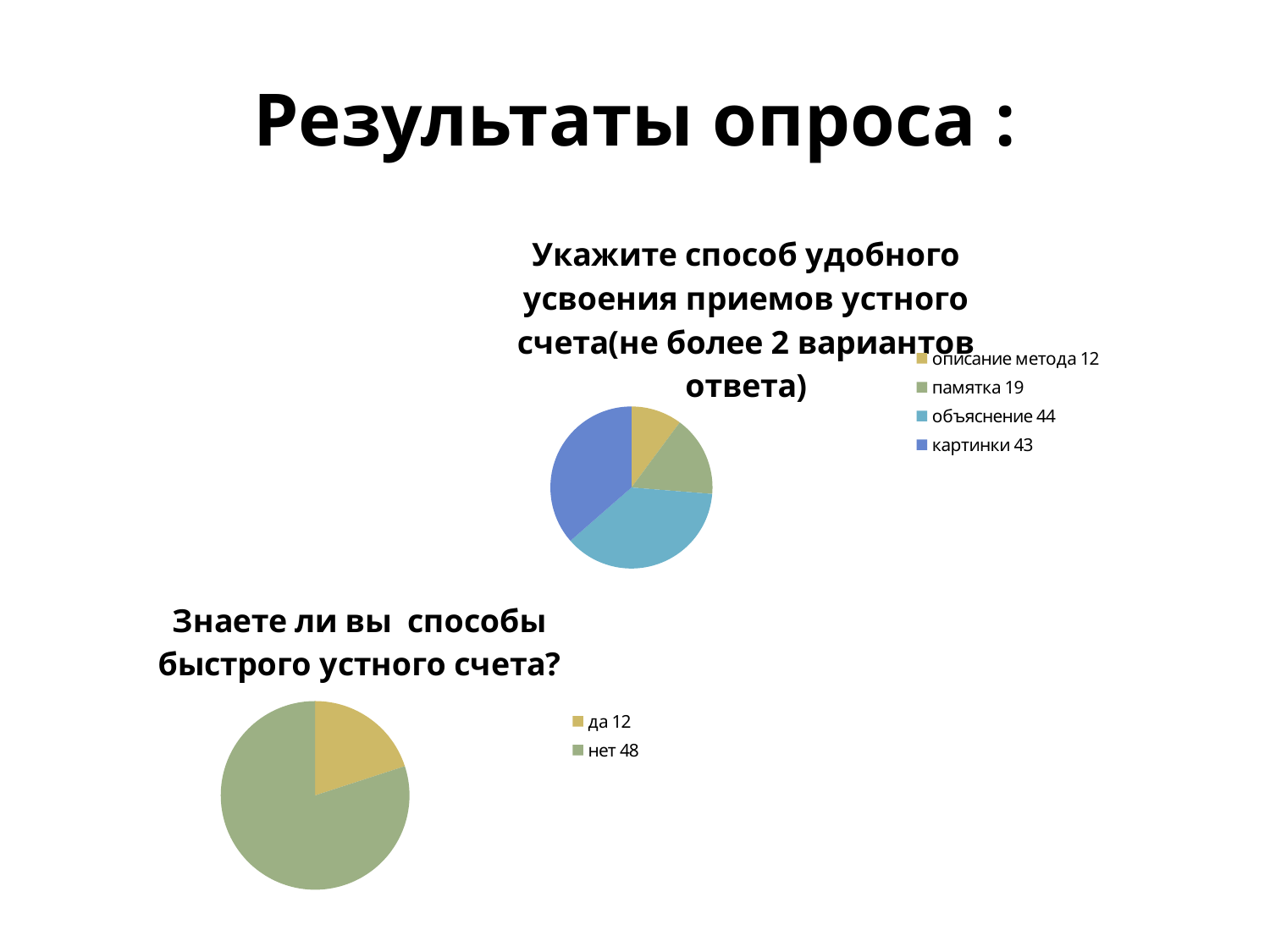
In the chart titled "Укажите способ удобного усвоения приемов устного счета", what colour is the slice for "картинки"? blue In the chart titled "Укажите способ удобного усвоения приемов устного счета", what value is given for "памятка"? 19 In the chart titled "Знаете ли вы способы быстрого устного счета?", which is larger, "да" or "нет"? нет What type of chart is the one titled "Знаете ли вы способы быстрого устного счета?"? pie chart In the chart titled "Укажите способ удобного усвоения приемов устного счета", which category has the largest value? объяснение In the chart titled "Укажите способ удобного усвоения приемов устного счета", which category has the smallest value? описание метода In the chart titled "Знаете ли вы способы быстрого устного счета?", what value is given for "нет"? 48 In the chart titled "Знаете ли вы способы быстрого устного счета?", what share of the pie does "да" represent? 20% In the chart titled "Укажите способ удобного усвоения приемов устного счета", what value is given for "объяснение"? 44 In the chart titled "Укажите способ удобного усвоения приемов устного счета", what is the difference between the values for "картинки" and "памятка"? 24 In the chart titled "Знаете ли вы способы быстрого устного счета?", what is the difference between the values for "нет" and "да"? 36 In the chart titled "Укажите способ удобного усвоения приемов устного счета", how many categories does the legend list? 4